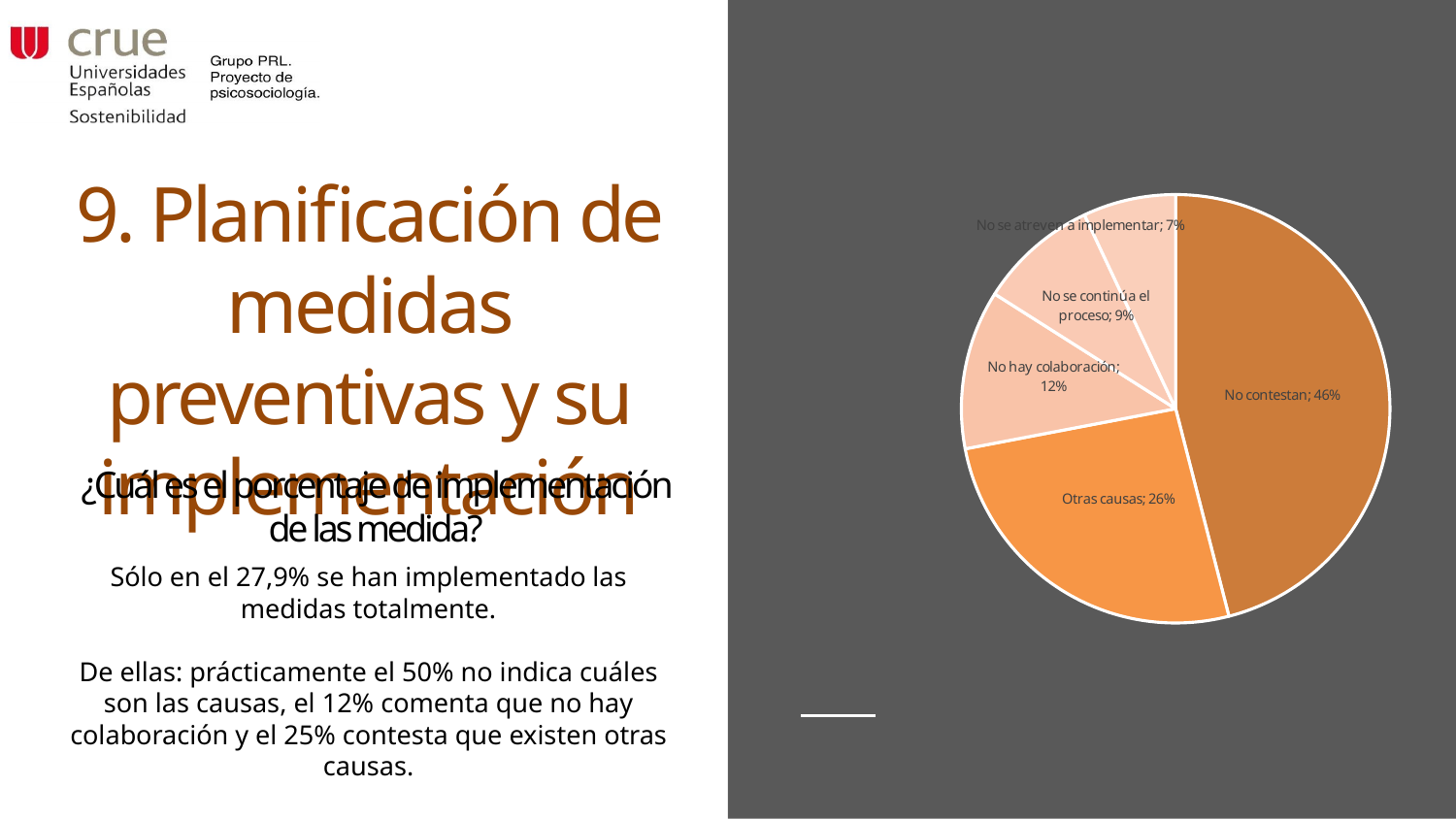
What is the difference between the values for "No contestan" and "Otras causas"? 20% What type of chart is shown on the slide? pie chart What is the value for "No se continúa el proceso" in the pie chart? 9% What is the value for "No contestan" in the pie chart? 46% What share of the pie does "Otras causas" represent? 26% Which category has the largest slice in the pie chart? No contestan What is the value for "No hay colaboración" in the pie chart? 12% What is the value for "No se atreven a implementar" in the pie chart? 7% Which category has the smallest slice in the pie chart? No se atreven a implementar Which is larger, "No hay colaboración" or "No se continúa el proceso"? No hay colaboración What is the value for "Otras causas" in the pie chart? 26% How many slices does the pie chart have? 5